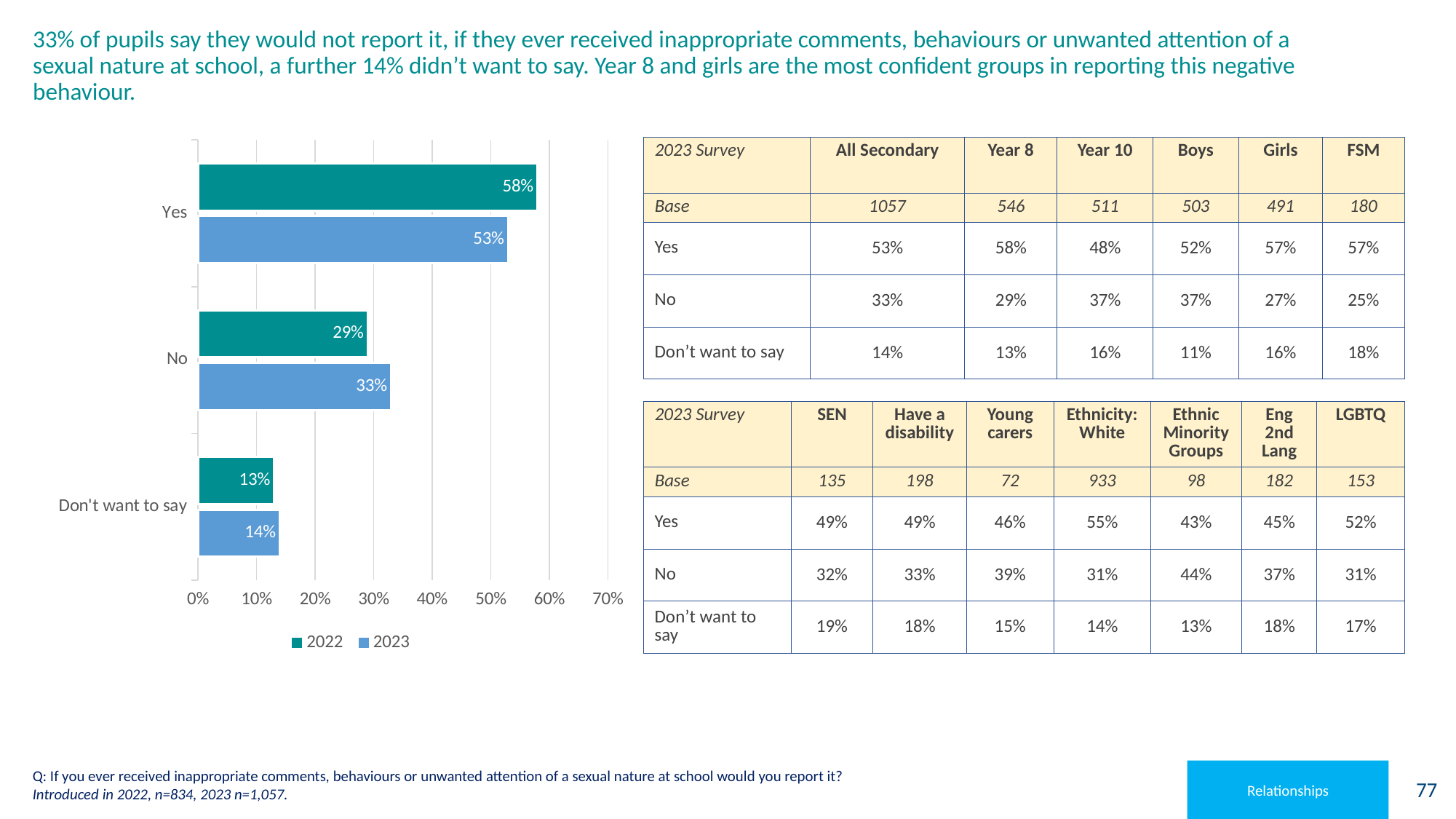
What is the value for 'Don't want to say' in the 2022 series? 13% Is the 2023 value for 'Yes' greater or less than 50%? greater Which series is shown in the lighter blue colour? 2023 What kind of chart is shown on the slide? Bar chart How many categories are shown on the chart? 3 Which is larger for 'No': the 2022 value or the 2023 value? 2023 What is the value for 'Yes' in the 2022 series? 58% What is the value for 'No' in the 2023 series? 33% Which category has the lowest value in the 2022 series? Don't want to say Which category has the highest value in the 2023 series? Yes How many series does the legend list? 2 What is the difference between the 2022 and 2023 values for 'Yes'? 5%